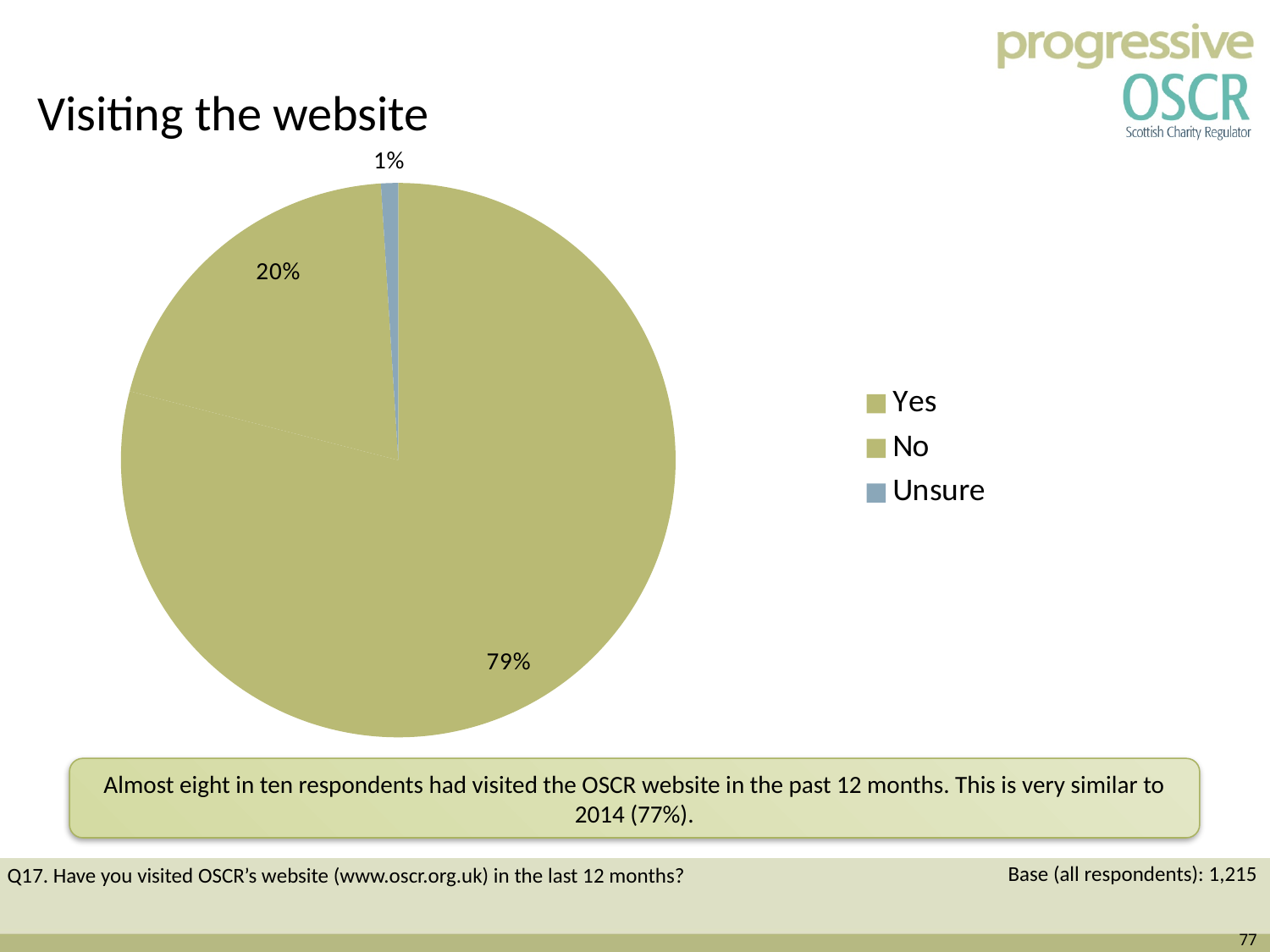
What share of the pie does the Yes slice take? 79% Which response has the smallest share of the pie? Unsure How many categories does the legend list? 3 What percentage of respondents answered No? 20% What kind of chart is shown on the slide? pie chart What is the base (number of respondents) stated for the chart? 1,215 Which response has the largest share of the pie? Yes What percentage of respondents answered Yes to visiting the website? 79% Which is larger, the share for No or the share for Unsure? No What is the difference in percentage points between the Yes and No shares? 59 What percentage of respondents were Unsure? 1% What is the title of the slide containing the chart? Visiting the website